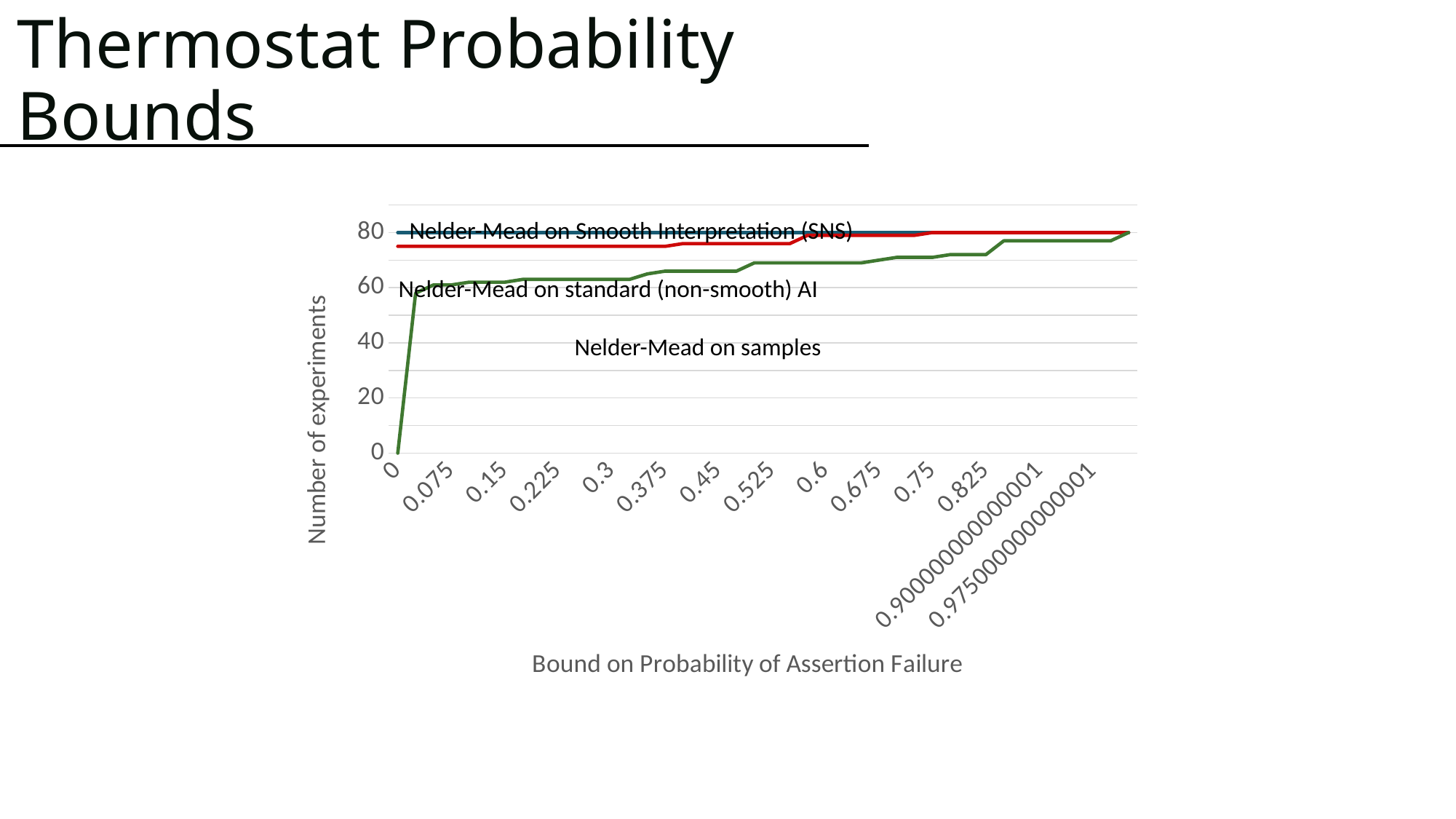
At a bound of 0.45, which series is higher: Nelder-Mead on standard (non-smooth) AI or Nelder-Mead on samples? Nelder-Mead on standard (non-smooth) AI How many labeled tick marks are on the x axis? 14 How many series are plotted in the chart? 3 What is the title of the y axis? Number of experiments Is the value for Nelder-Mead on samples at a bound of 0.3 greater or less than 40? greater Does the Nelder-Mead on samples series rise or fall as the bound on probability of assertion failure increases? rise What is the title of the x axis? Bound on Probability of Assertion Failure Which series has the highest number of experiments at a bound of 0.3? Nelder-Mead on Smooth Interpretation (SNS) Is the value for Nelder-Mead on standard (non-smooth) AI at a bound of 0.075 greater or less than 60? greater What kind of chart is shown on the slide? line chart Is the value for Nelder-Mead on samples at a bound of 0.075 greater or less than 40? greater Which series has the lowest number of experiments at a bound of 0.3? Nelder-Mead on samples